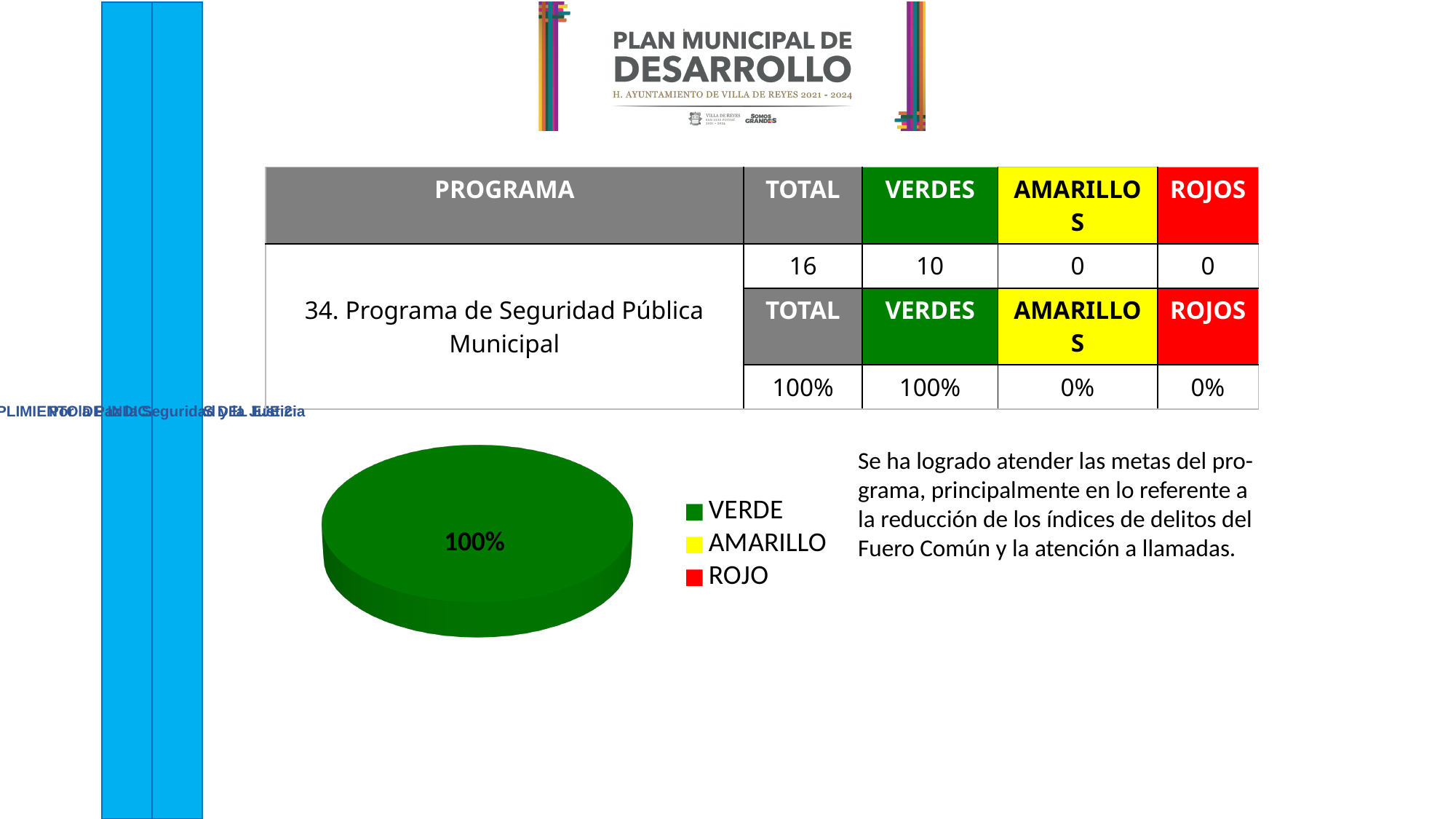
What colour is the VERDE slice in the pie chart? green What is the data label printed on the pie chart? 100% What kind of chart is shown on the slide? pie chart How many entries does the pie chart's legend list? 3 What colour does the legend assign to AMARILLO? yellow Which legend category makes up the entire pie chart? VERDE How many visible slices does the pie chart have? 1 What share of the pie does the VERDE slice represent? 100%